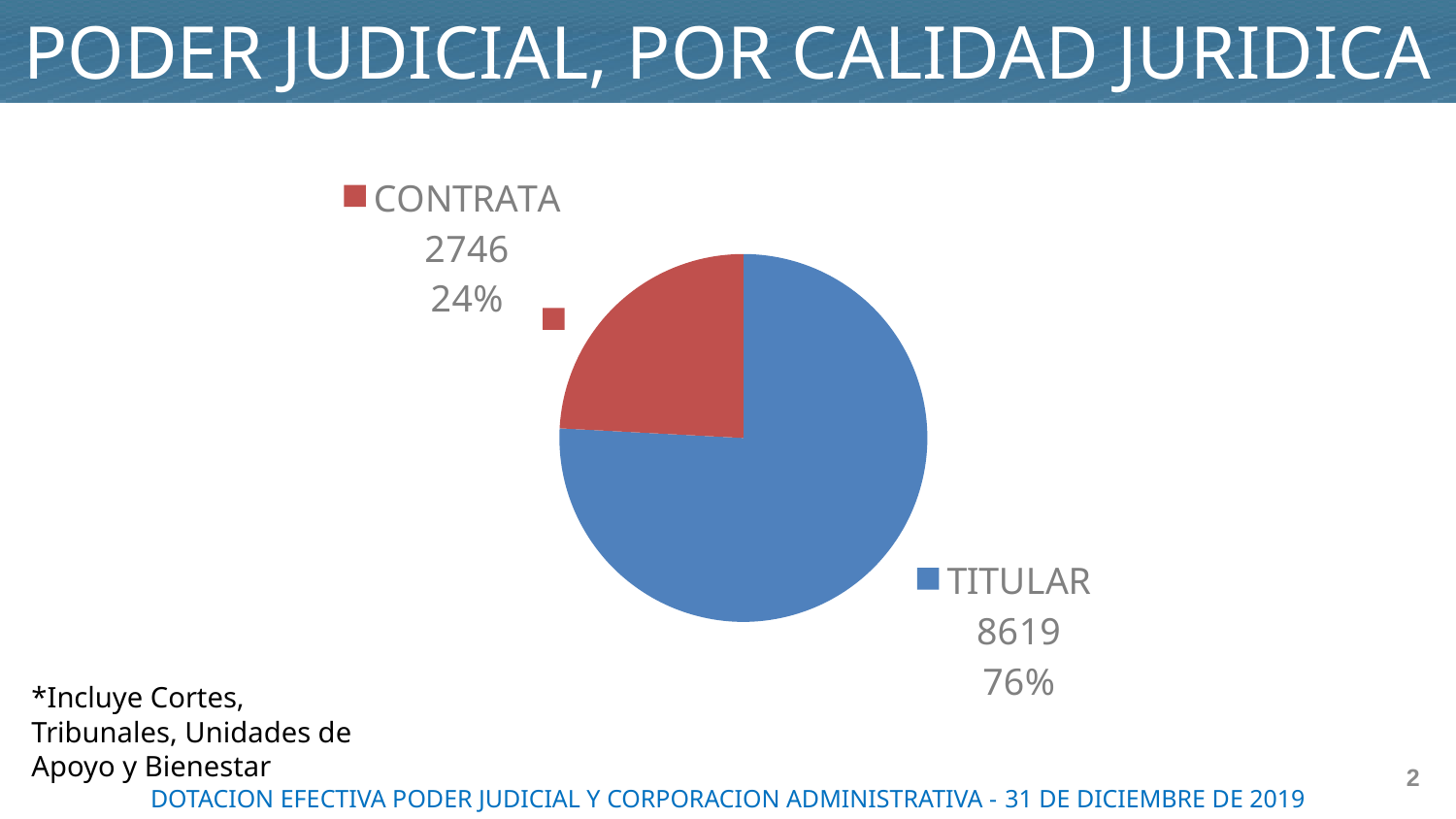
What is the value for CONTRATA? 2746 How many categories are shown in the pie chart? 2 What colour is the TITULAR slice? blue Which category has the largest slice? TITULAR What is the difference between the TITULAR and CONTRATA values? 5873 What is the total of the two values shown in the pie chart? 11365 What is the value for TITULAR? 8619 What kind of chart is shown on the slide? pie chart What percentage share does TITULAR have? 76% What percentage share does CONTRATA have? 24% Which category has the smallest slice? CONTRATA Which is larger, TITULAR or CONTRATA? TITULAR